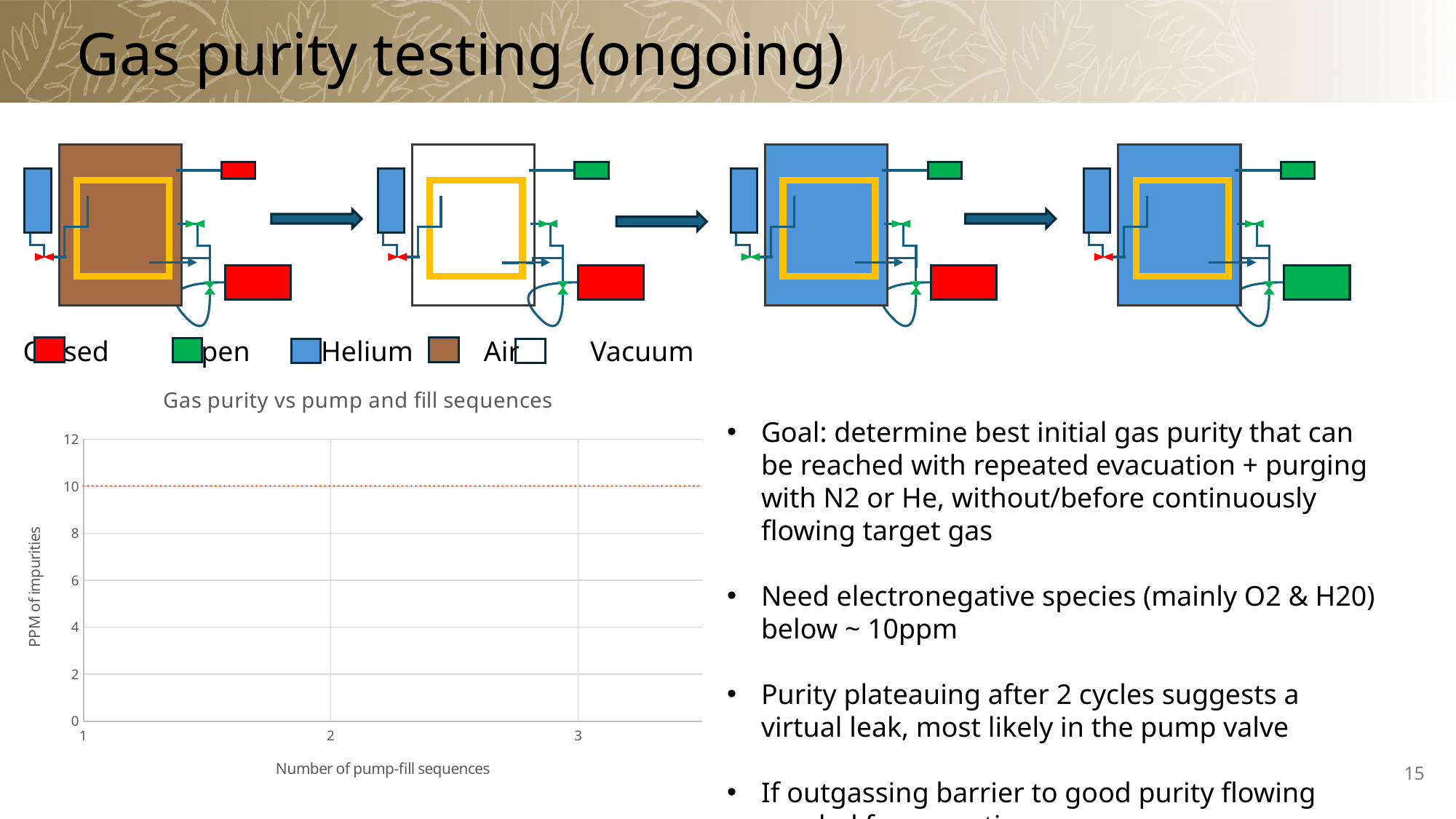
Is the dotted line in the chart greater or less than 8 PPM of impurities? greater Is the dotted line in the chart greater or less than 12 PPM of impurities? less What is the label of the vertical axis of the chart? PPM of impurities Does the dotted line in the chart rise, fall, or stay flat from sequence 1 to sequence 3? stays flat At what value on the vertical axis does the dotted horizontal line sit? 10 What kind of chart is shown on the slide? line chart What is the title of the chart on the slide? Gas purity vs pump and fill sequences How many pump-fill sequence values are labelled along the x axis of the chart? 3